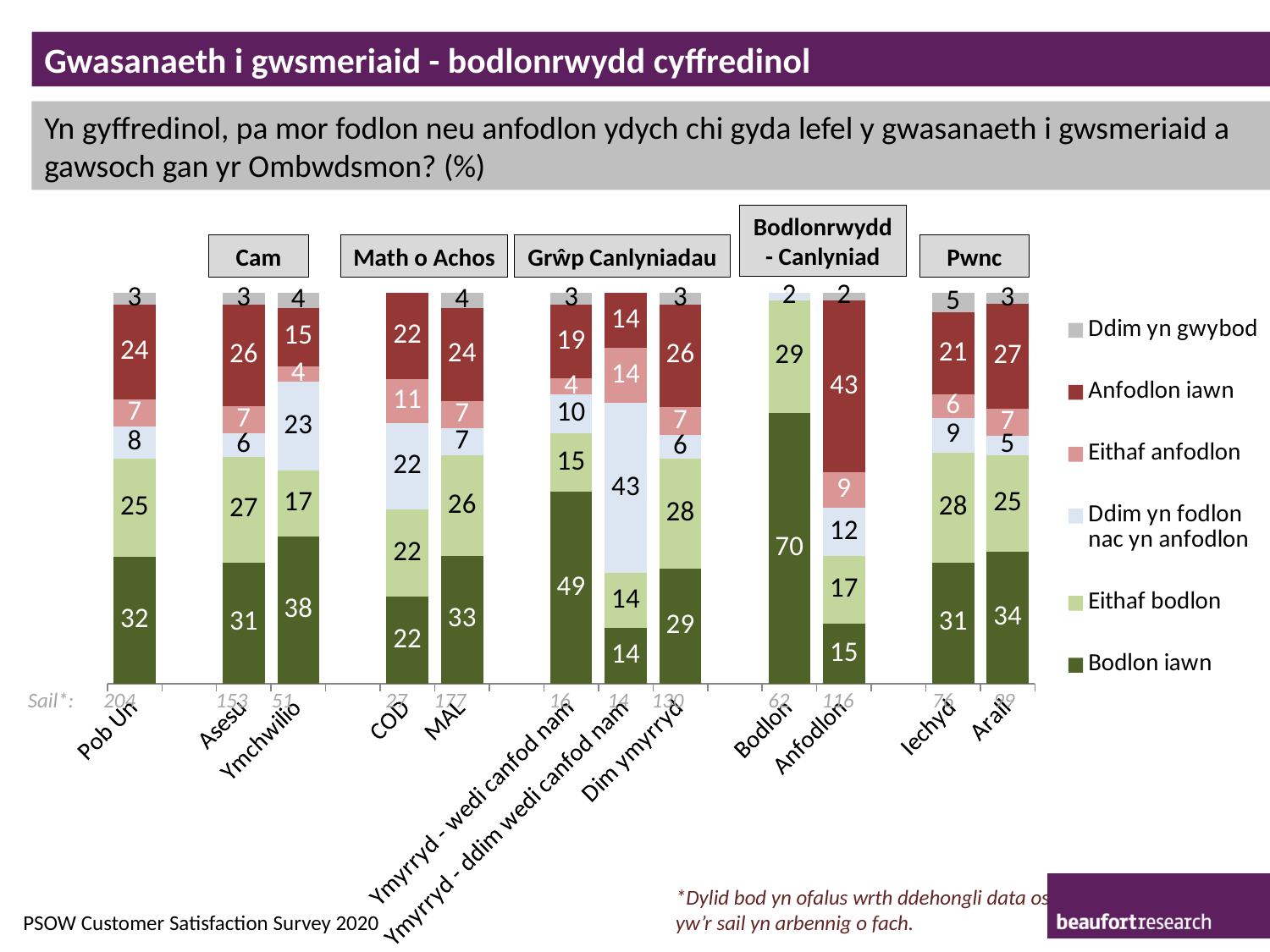
Which is larger: the 'Anfodlon iawn' value for Arall or for Iechyd? Arall What is the combined value of 'Bodlon iawn' and 'Eithaf bodlon' for MAL? 59 What is the value of 'Ddim yn fodlon nac yn anfodlon' for Ymyrryd - ddim wedi canfod nam? 43 How many series does the legend list? 6 What is the value of 'Bodlon iawn' for Pob Un? 32 What is the difference between the 'Bodlon iawn' values for Ymchwilio and Asesu? 7 What kind of chart is shown? Stacked bar chart What is the value of 'Anfodlon iawn' for Anfodlon? 43 What is the value of 'Eithaf bodlon' for Iechyd? 28 How many categories are shown on the x axis? 12 Which category has the highest 'Bodlon iawn' value? Bodlon